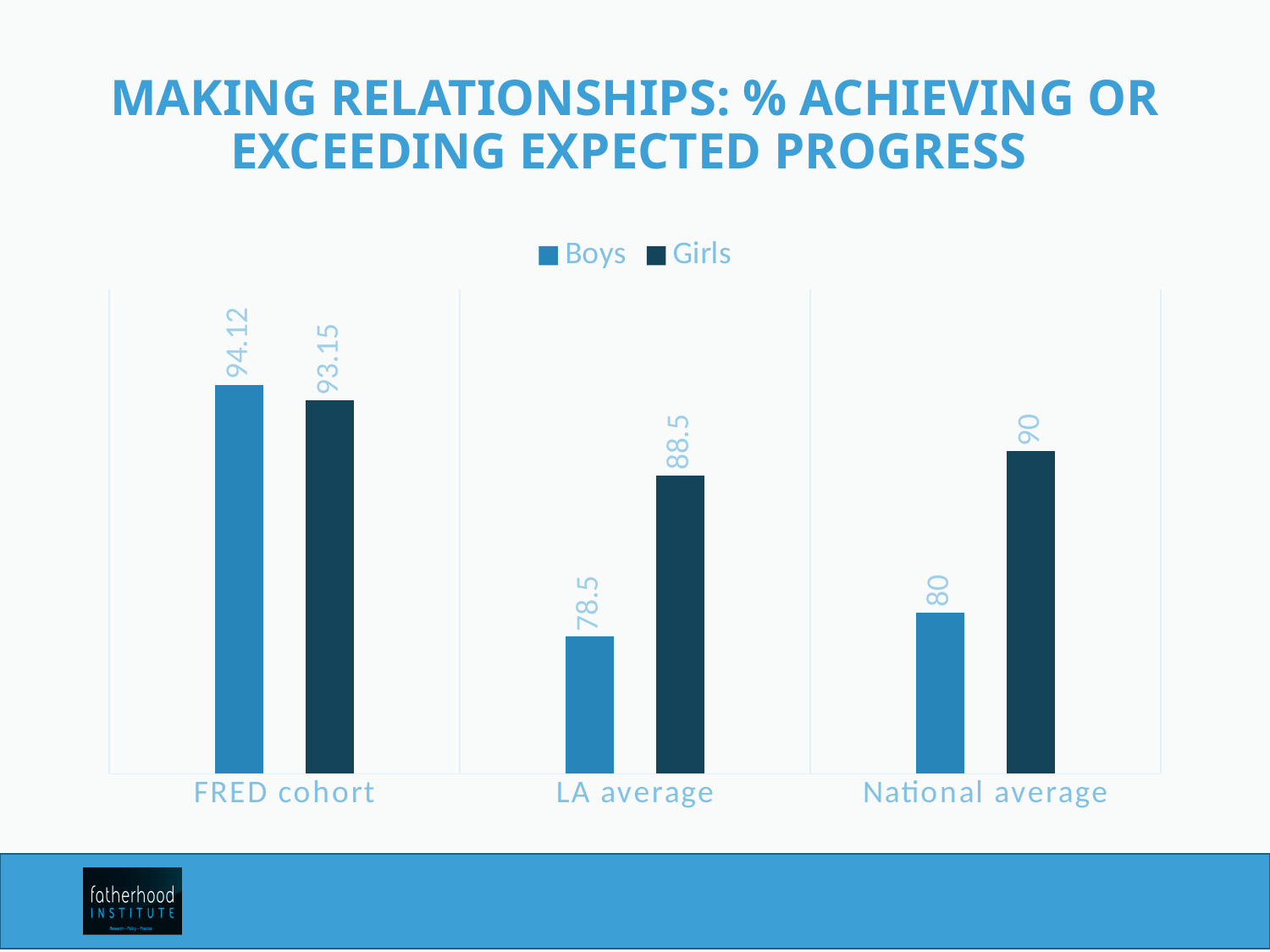
How many series does the legend list? 2 How many categories are shown on the x axis? 3 What kind of chart is shown on the slide? Bar chart What is the value for Girls in the National average? 90 Which is larger in the LA average, the Boys value or the Girls value? Girls What is the difference between the Girls and Boys values in the National average? 10 Which category has the highest value for Boys? FRED cohort What is the value for Boys in the National average? 80 What is the value for Boys in the FRED cohort? 94.12 What is the difference between the Girls and Boys values in the LA average? 10 What is the value for Girls in the LA average? 88.5 Which category has the lowest value for Boys? LA average